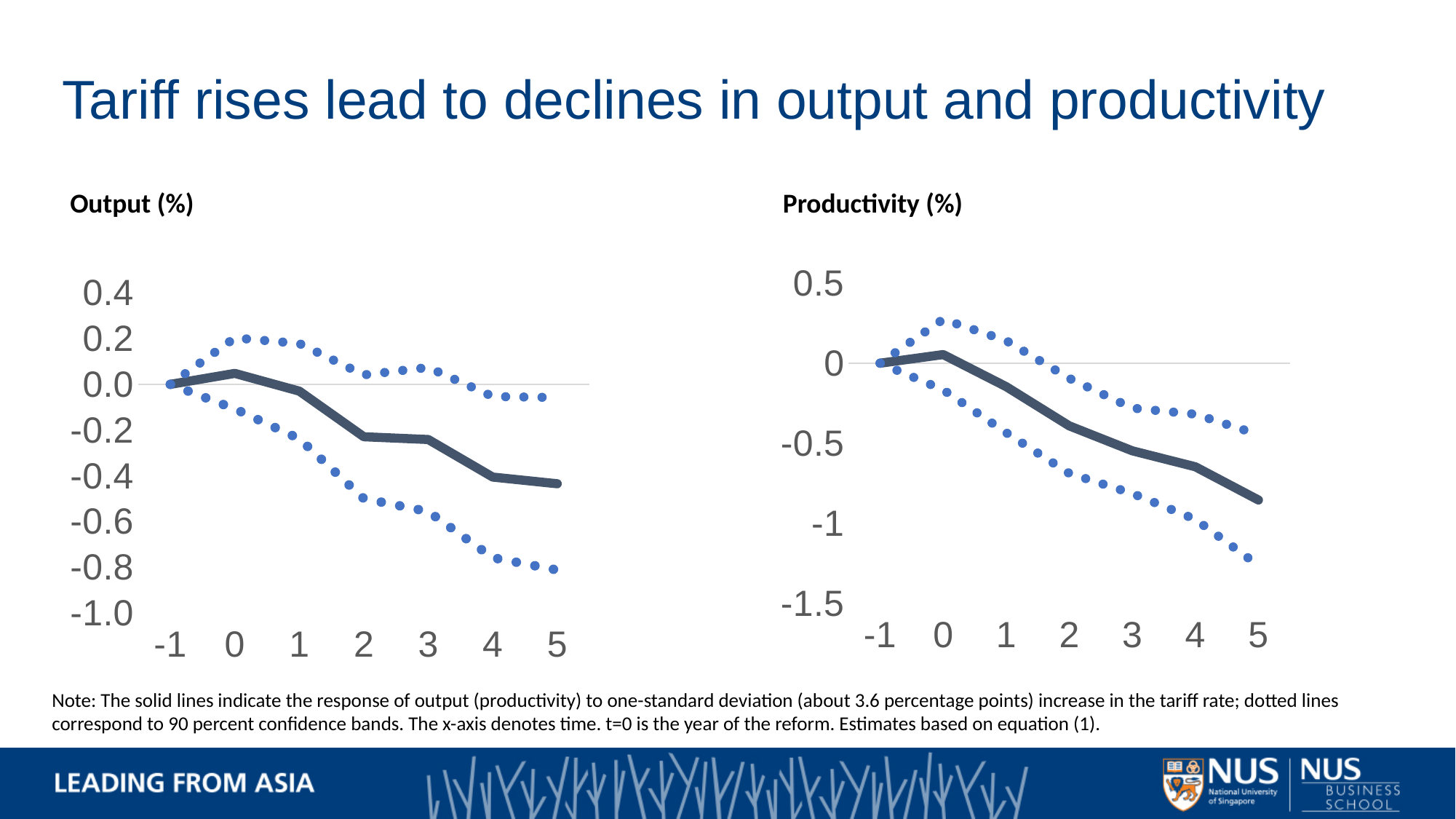
In the Output (%) chart, at which time point does the solid line reach its highest value? 0 How many time points are shown on the x axis of the Productivity (%) chart? 7 What kind of chart is the Output (%) chart? line chart In the Output (%) chart, which is larger, the solid line value at t=0 or at t=5? t=0 In the Productivity (%) chart, does the solid line rise or fall from t=0 to t=5? fall In the Output (%) chart, does the solid line rise or fall from t=0 to t=5? fall According to the note, what do the dotted lines in the charts represent? 90 percent confidence bands In the Productivity (%) chart, is the solid line value at t=5 greater or less than -0.5? less In the Productivity (%) chart, which is larger, the solid line value at t=1 or at t=4? t=1 In the Output (%) chart, is the solid line value at t=3 greater or less than 0.0? less In the Productivity (%) chart, is the lower dotted band at t=5 greater or less than -1? less In the Productivity (%) chart, at which time point does the solid line reach its lowest value? 5